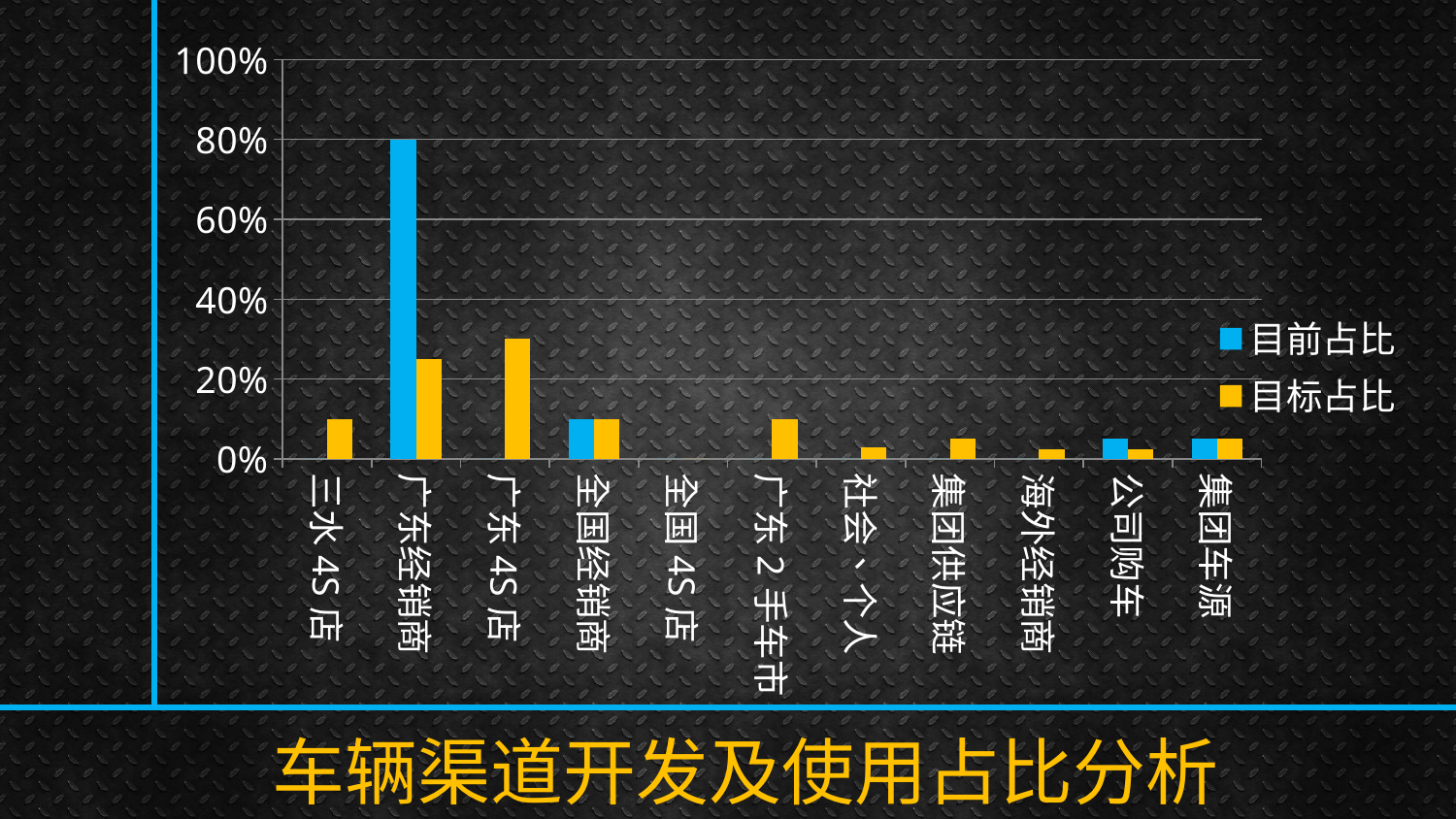
Which category has the highest 目前占比 value? 广东经销商 How many categories are shown along the x axis? 11 What is the 目前占比 value for 广东经销商? 80% Which has a larger 目标占比 value: 广东4S店 or 三水4S店? 广东4S店 For 广东经销商, which is larger: 目前占比 or 目标占比? 目前占比 What is the title shown below the chart? 车辆渠道开发及使用占比分析 Is the 目标占比 value for 广东4S店 greater or less than 40%? less What kind of chart is shown on the slide? bar chart Is the 目标占比 value for 三水4S店 greater or less than 20%? less Which category has the highest 目标占比 value? 广东4S店 What are the two series named in the legend? 目前占比 and 目标占比 How many series does the legend list? 2